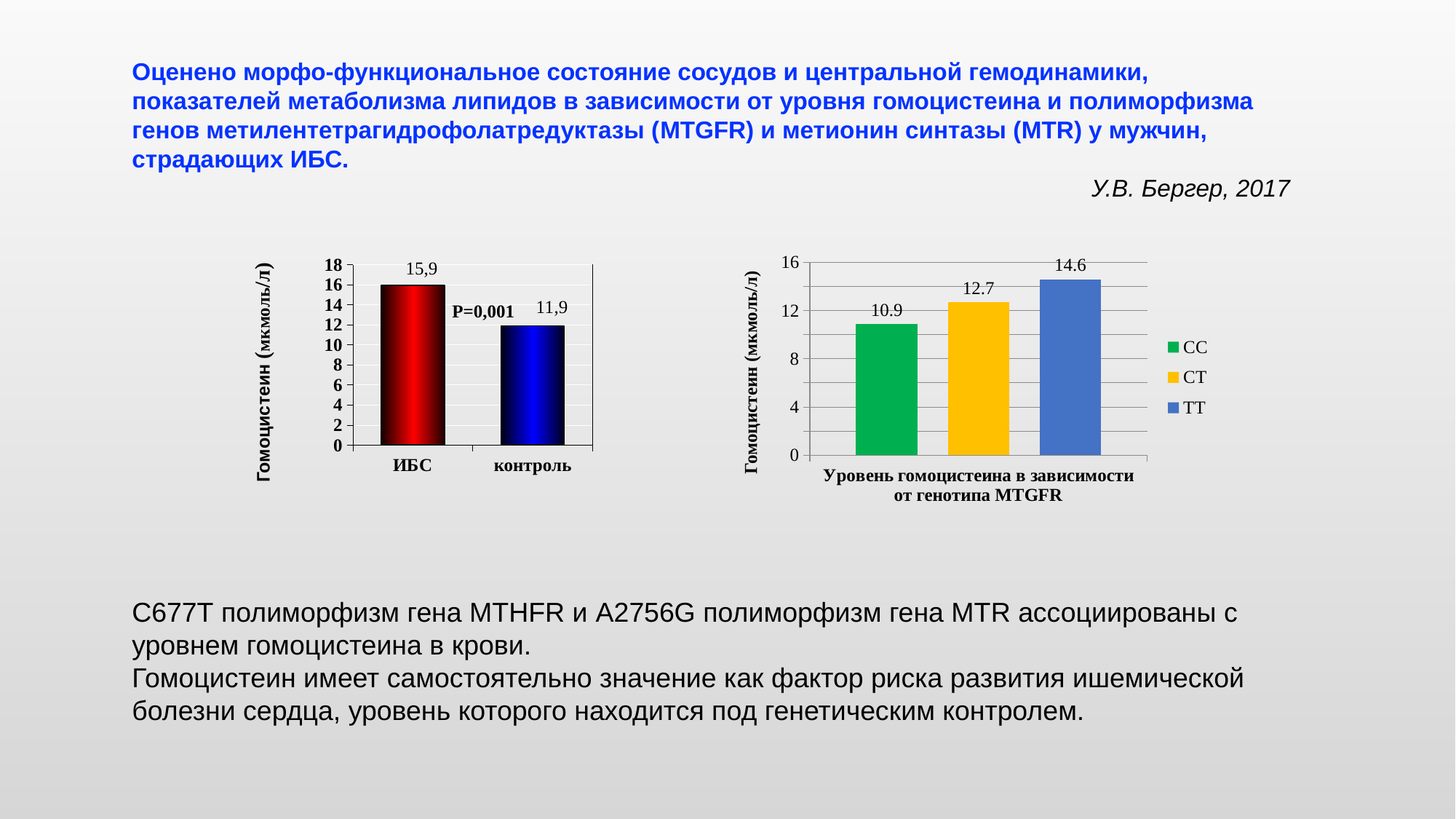
In the left chart, what P value is printed between the bars? P=0,001 What kind of chart is the right chart? Bar chart In the right chart, which genotype has the highest homocysteine value? TT In the right chart, what is the homocysteine value for the CT genotype? 12.7 In the left chart, what is the difference between the ИБС and контроль values? 4,0 In the left chart, which group has the higher homocysteine value, ИБС or контроль? ИБС In the right chart, which genotype has the lowest homocysteine value? CC In the right chart, what is the difference between the TT and CC values? 3.7 In the right chart, what is the homocysteine value for the TT genotype? 14.6 How many series does the legend of the right chart list? 3 In the left chart, what is the homocysteine value for ИБС? 15,9 In the left chart, what is the homocysteine value for контроль? 11,9